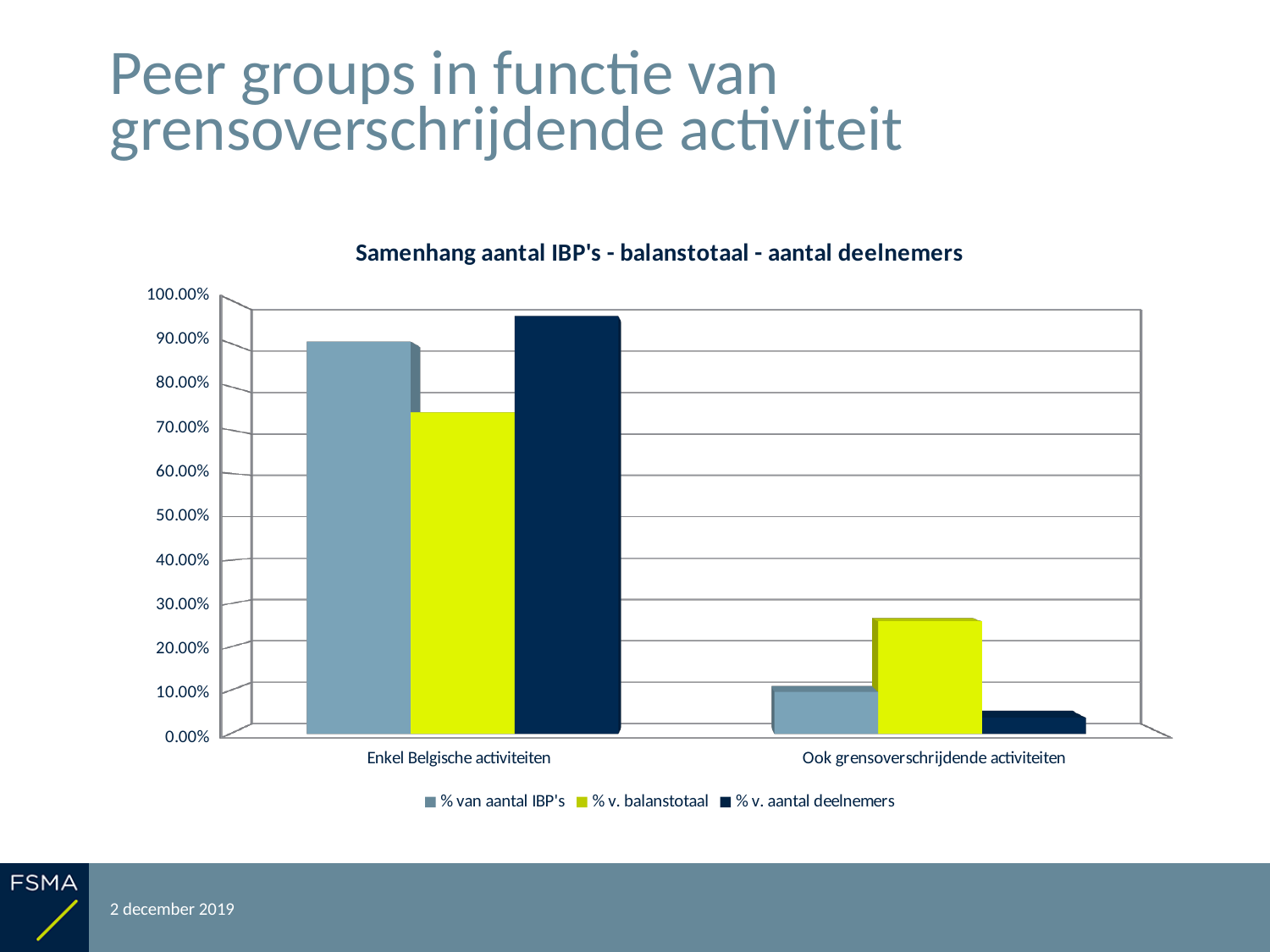
Which series has the lowest value for Enkel Belgische activiteiten? % v. balanstotaal Which series has the highest value for Enkel Belgische activiteiten? % v. aantal deelnemers How many categories are shown on the x axis? 2 What is the title of the chart? Samenhang aantal IBP's - balanstotaal - aantal deelnemers What kind of chart is shown on the slide? bar chart Which series has the highest value for Ook grensoverschrijdende activiteiten? % v. balanstotaal Which is larger for Enkel Belgische activiteiten: % van aantal IBP's or % v. balanstotaal? % van aantal IBP's Is the value of % v. balanstotaal for Enkel Belgische activiteiten greater or less than 80.00%? less Which series has the lowest value for Ook grensoverschrijdende activiteiten? % v. aantal deelnemers How many series does the legend list? 3 Is the value of % v. balanstotaal for Ook grensoverschrijdende activiteiten greater or less than 20.00%? greater Is the value of % v. aantal deelnemers for Enkel Belgische activiteiten greater or less than 90.00%? greater